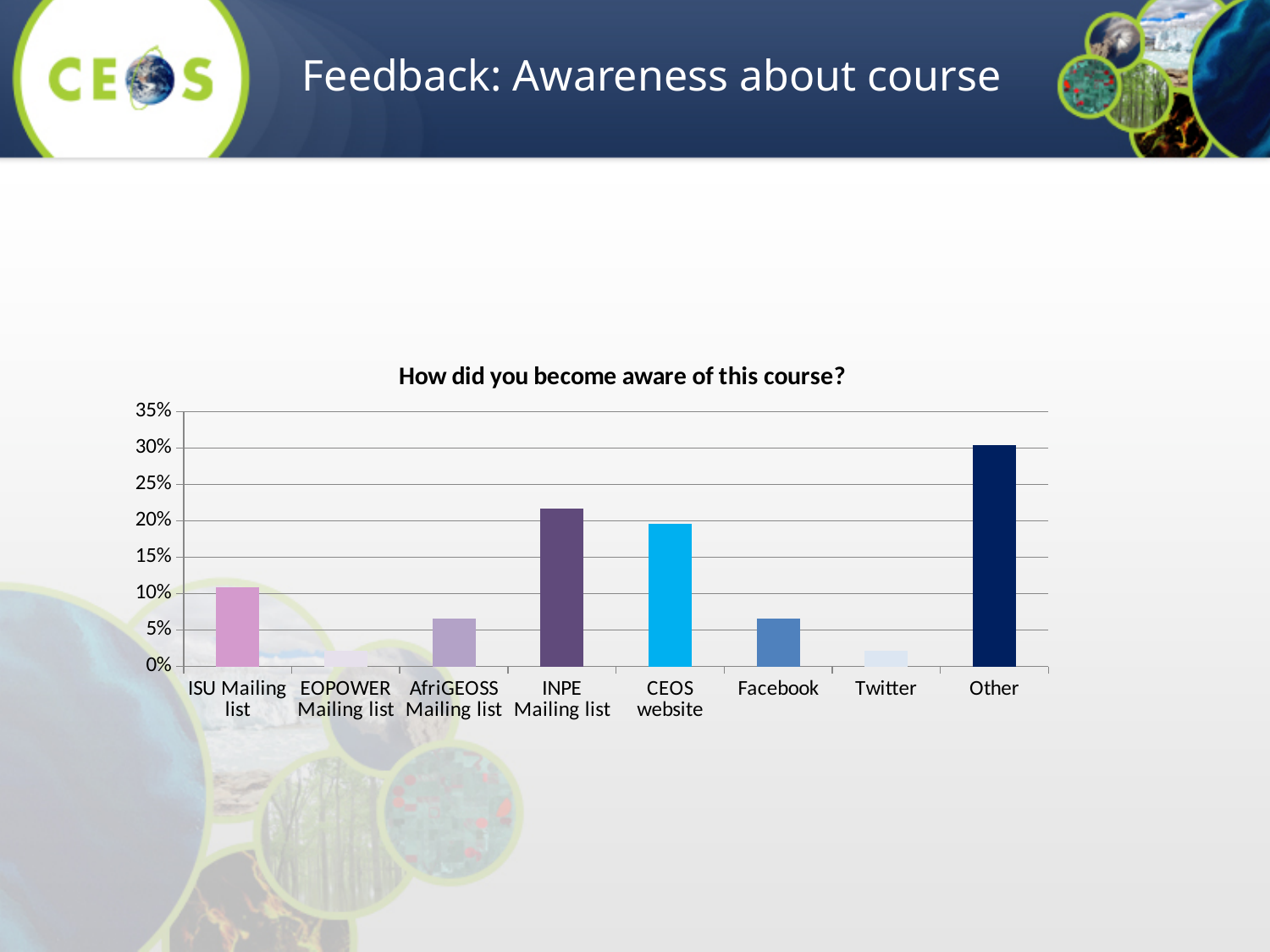
Is the value for Other greater or less than 25%? greater Which is larger, the value for Other or the value for INPE Mailing list? Other Is the value for EOPOWER Mailing list greater or less than 5%? less Which category has the highest value? Other Is the value for Facebook greater or less than 10%? less How many categories are shown on the x axis of the chart? 8 Which is larger, the value for ISU Mailing list or the value for Facebook? ISU Mailing list What type of chart is shown on the slide? bar chart What is the title of the chart? How did you become aware of this course?